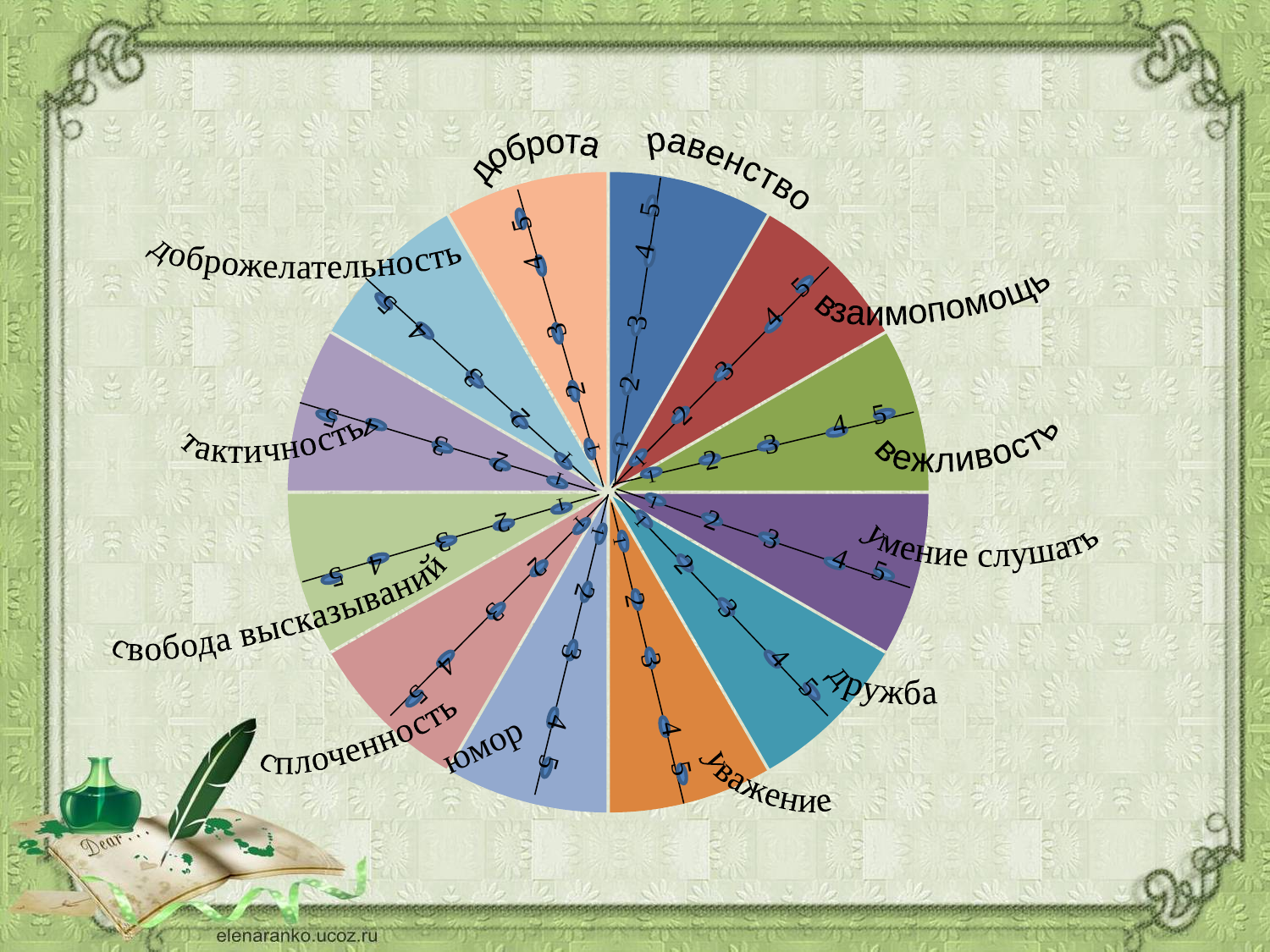
How many slices (categories) does the pie chart have? 12 What is the lowest number marked on the scale drawn along each slice of the pie chart? 1 What kind of chart is shown on the slide? pie chart Which category label is written next to the light blue slice at the upper left of the pie chart? доброжелательность Which category label is written next to the dark red slice at the upper right of the pie chart? взаимопомощь Which category label is written next to the teal slice at the lower right of the pie chart? дружба Which category label is written next to the green slice on the right side of the pie chart? вежливость What is the highest number marked on the scale drawn along each slice of the pie chart? 5 Which category label is written above the dark blue slice at the top of the pie chart? равенство Which category label is written next to the purple slice on the right side of the pie chart, below вежливость? умение слушать Which category label is written next to the light green slice on the left side of the pie chart? свобода высказываний Which category label is written next to the orange slice at the bottom of the pie chart? уважение